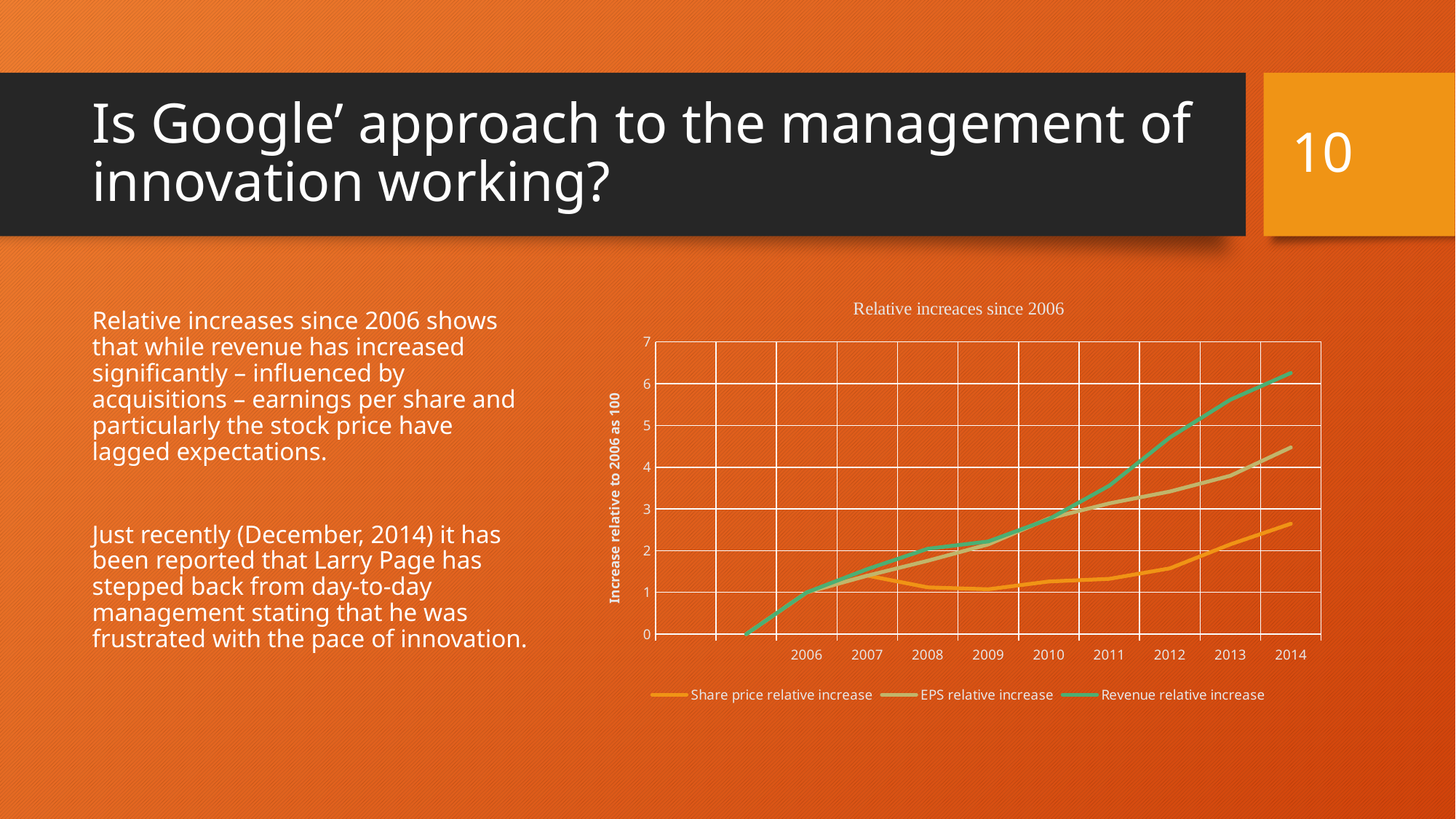
Does the Revenue relative increase line rise or fall from 2006 to 2014? Rise What kind of chart is shown on the slide? Line chart Is the value for EPS relative increase in 2014 greater or less than 4? greater How many series does the chart's legend list? 3 Is the value for Revenue relative increase in 2014 greater or less than 6? greater Which series has the highest value in 2014? Revenue relative increase Which series has the lowest value in 2014? Share price relative increase What is the title of the chart? Relative increaces since 2006 Is the value for Revenue relative increase in 2012 greater or less than 4? greater How many year labels are shown on the x axis of the chart? 9 In 2013, which is larger: EPS relative increase or Share price relative increase? EPS relative increase